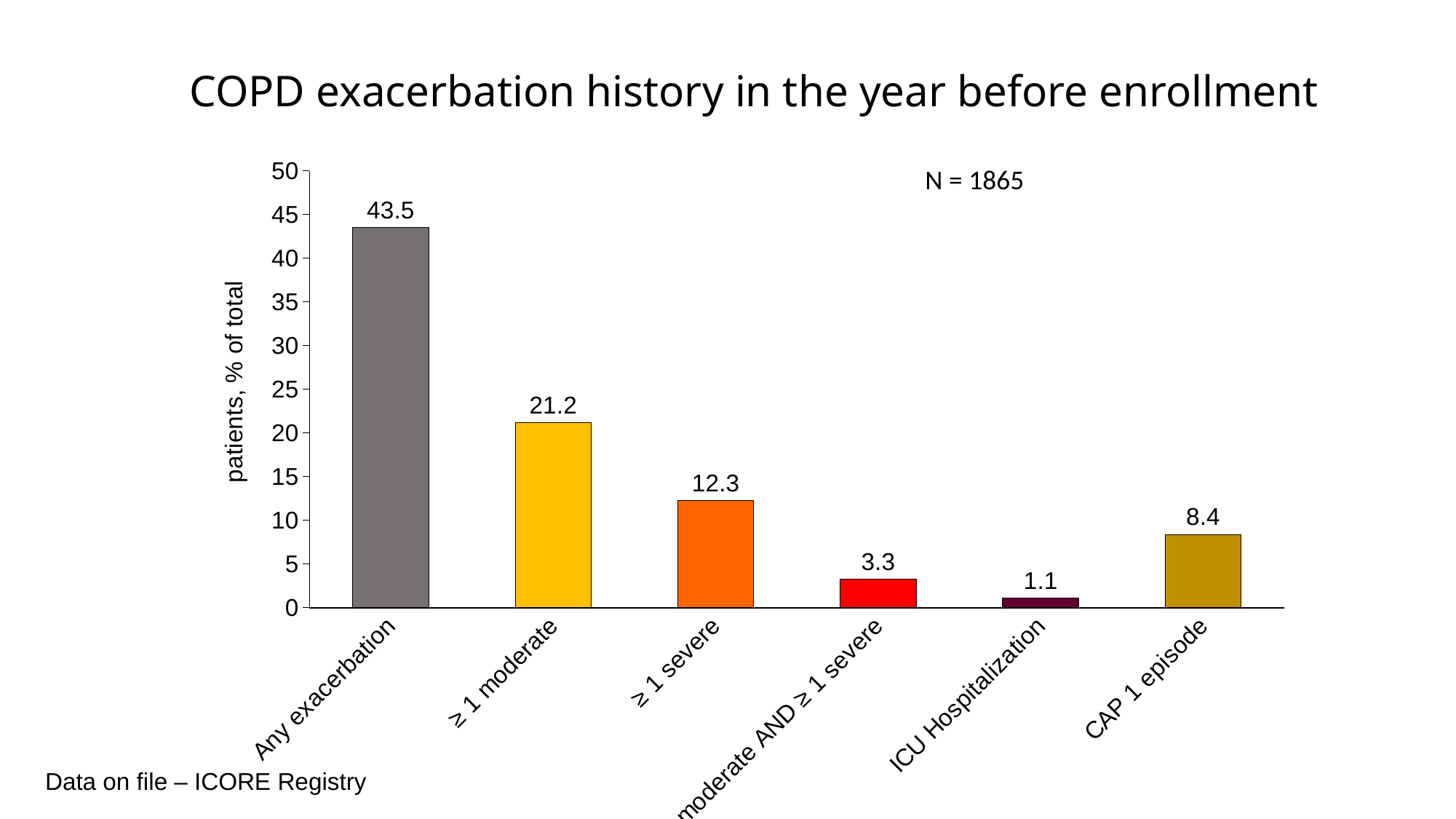
What kind of chart is shown on the slide? Bar chart What is the value for ICU Hospitalization? 1.1 Which category has the lowest value? ICU Hospitalization What is the difference between the values for ≥ 1 moderate and ≥ 1 severe? 8.9 What is the value for ≥ 1 moderate? 21.2 Which is larger, the value for CAP 1 episode or the value for moderate AND ≥ 1 severe? CAP 1 episode Is the value for ≥ 1 severe greater or less than 10? greater What is the title of the chart? COPD exacerbation history in the year before enrollment What is the value for Any exacerbation? 43.5 What is the value for CAP 1 episode? 8.4 How many categories are shown on the x axis? 6 Which category has the highest value? Any exacerbation